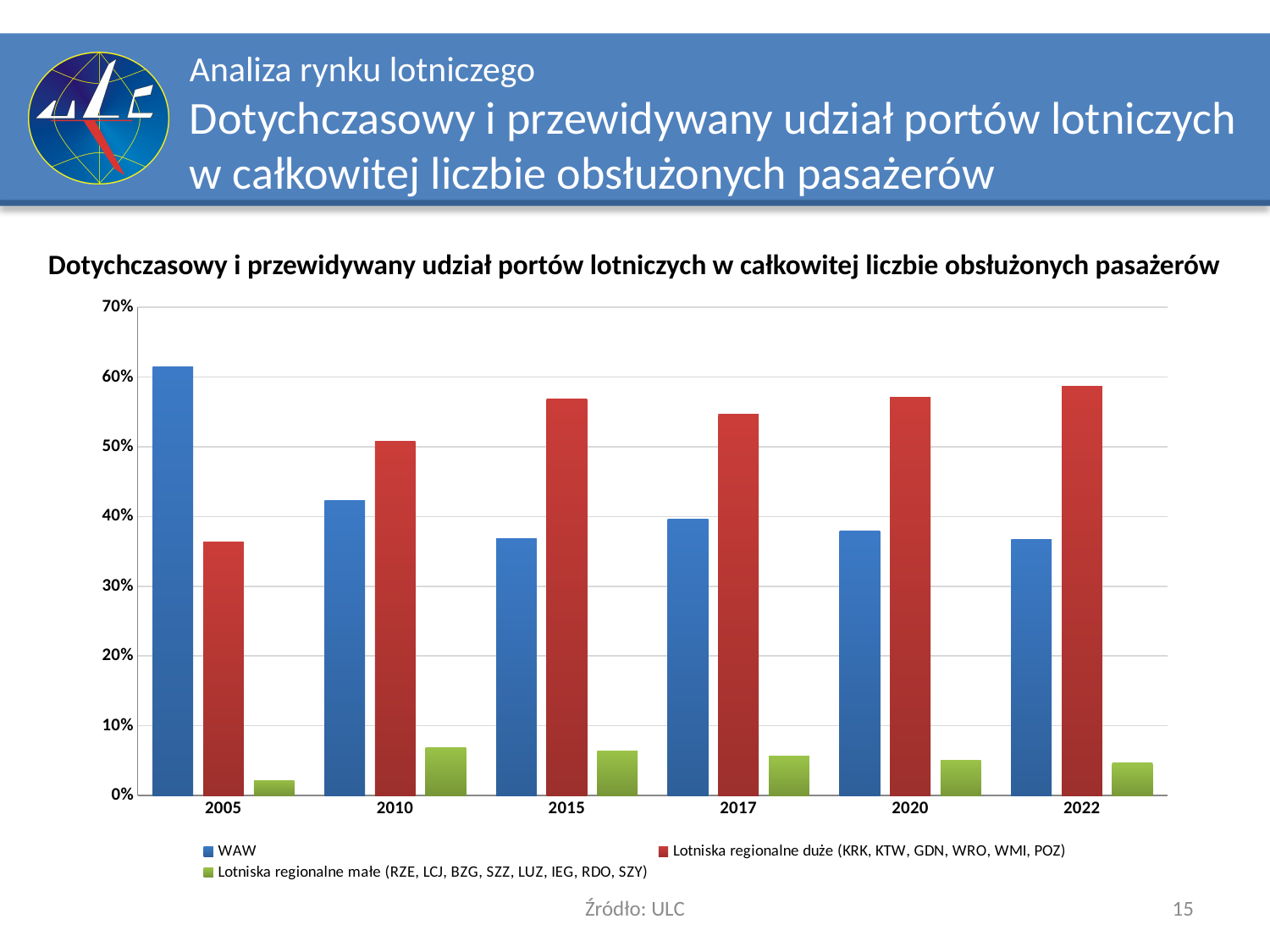
In which year is the share of Lotniska regionalne małe the lowest? 2005 What kind of chart is shown on the slide? bar chart Is the value for Lotniska regionalne małe in 2010 greater or less than 10%? less Is the WAW value for 2005 greater or less than 60%? greater Does the share of Lotniska regionalne duże rise or fall from 2005 to 2022? rise Which colour represents WAW in the chart? blue How many years are shown on the x axis? 6 In which year is the WAW share the highest? 2005 How many series does the legend list? 3 Is the value for Lotniska regionalne duże in 2005 greater or less than 40%? less In 2010, which is larger: the share of WAW or the share of Lotniska regionalne duże? Lotniska regionalne duże